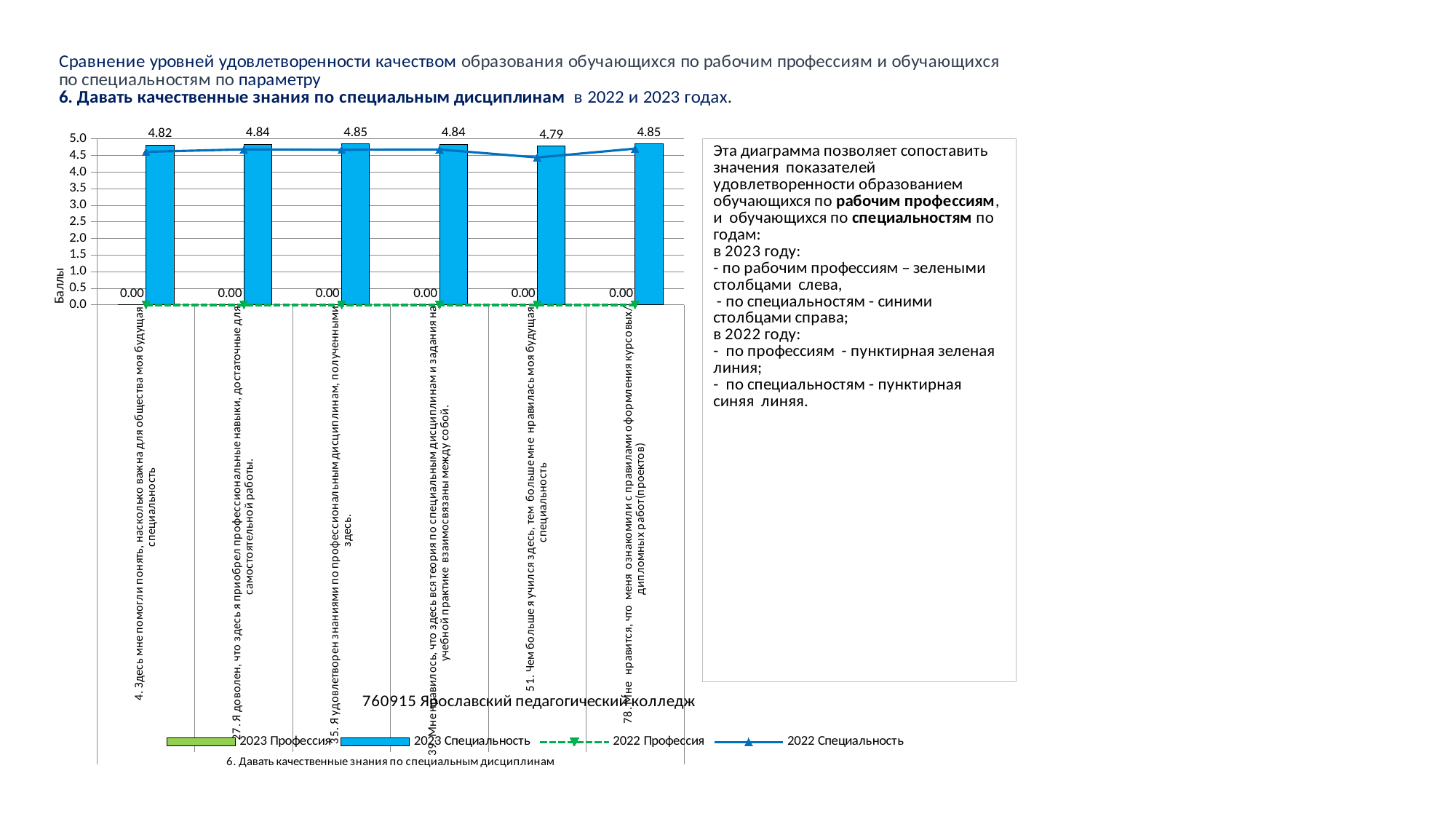
What is the 2023 Специальность value for item 51 (Чем больше я учился здесь, тем больше мне нравилась моя будущая специальность)? 4.79 Is the 2022 Специальность value for item 4 greater or less than 4.0? greater What kind of chart is this? Combined bar and line chart What is the label of the vertical axis? Баллы How many series does the legend list? 4 What is the 2023 Специальность value for item 4 (Здесь мне помогли понять, насколько важна для общества моя будущая специальность)? 4.82 What is the difference between the 2023 Специальность values for item 78 and item 51? 0.06 How many categories (items) are plotted on the chart? 6 What is the 2023 Специальность value for item 78 (Мне нравится, что меня ознакомили с правилами оформления курсовых/дипломных работ)? 4.85 Which item has the lowest 2023 Специальность value? 51. Чем больше я учился здесь, тем больше мне нравилась моя будущая специальность